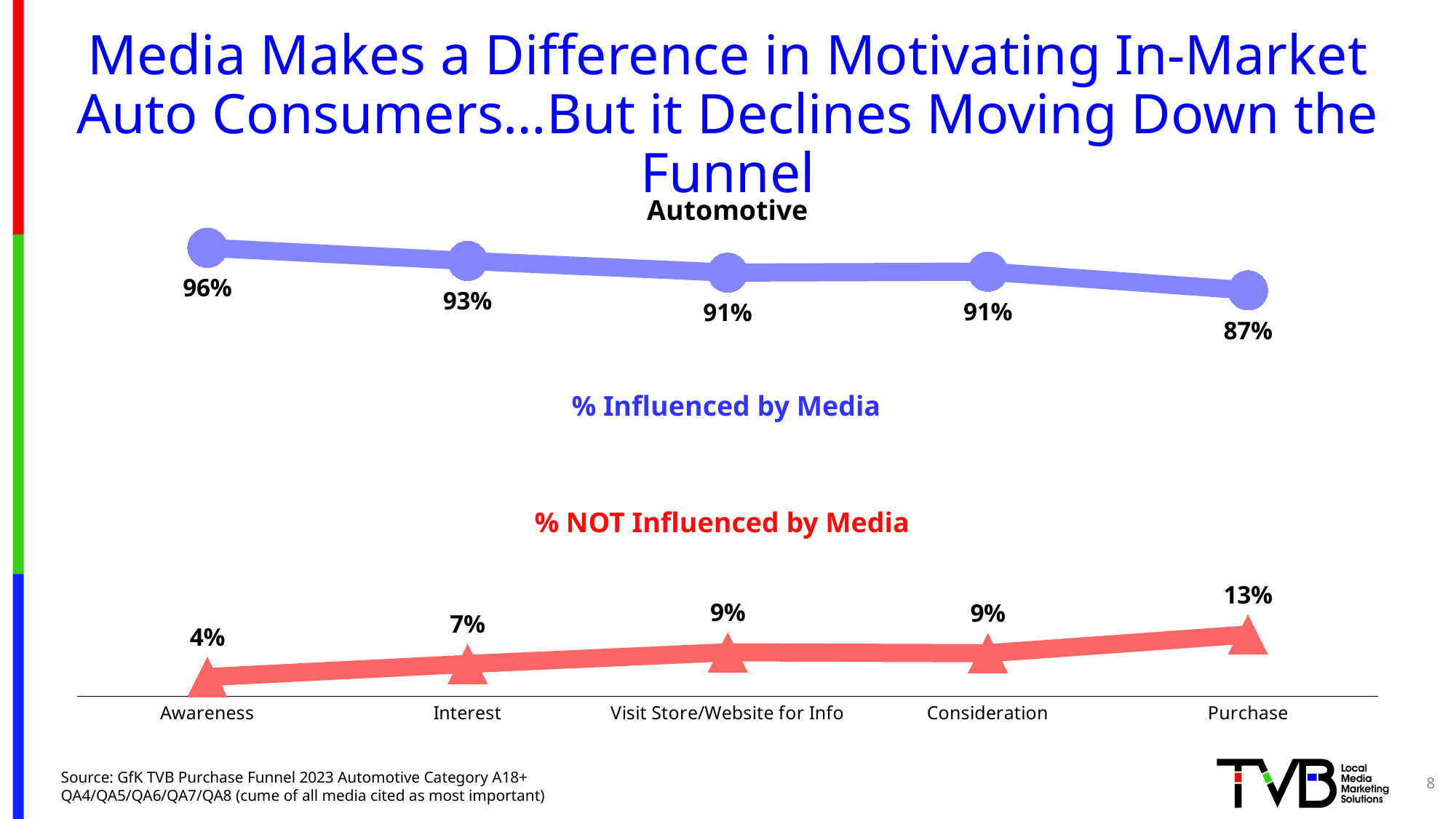
What is the difference between the % Influenced by Media at Awareness and at Purchase? 9 percentage points How many data series are plotted on the chart? 2 What is the % Influenced by Media value at the Awareness stage? 96% Which is larger: the % NOT Influenced by Media at Visit Store/Website for Info or at Purchase? Purchase What type of chart is shown on the slide? Line chart How many funnel stages are shown on the x axis? 5 Does the % Influenced by Media rise or fall moving from Awareness to Purchase? Fall What is the % NOT Influenced by Media value at the Purchase stage? 13% At which funnel stage is the % Influenced by Media lowest? Purchase What is the % Influenced by Media value at the Consideration stage? 91% At which funnel stage is the % NOT Influenced by Media lowest? Awareness What is the % NOT Influenced by Media value at the Interest stage? 7%